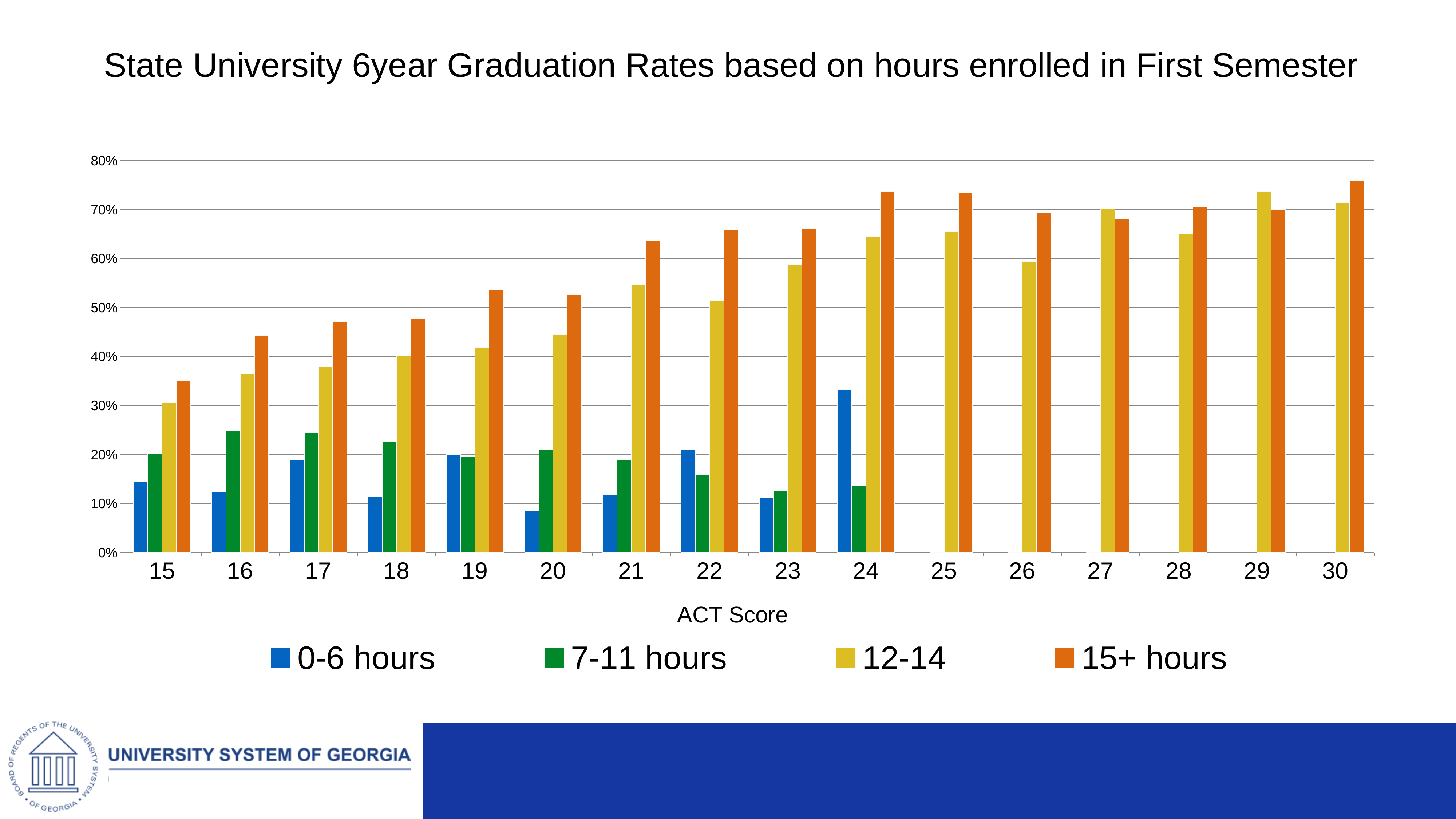
At ACT score 24, which is larger: 0-6 hours or 7-11 hours? 0-6 hours How many ACT score categories are shown on the x axis? 16 Is the value for 15+ hours at ACT score 30 greater or less than 70%? greater Do the 15+ hours values generally rise or fall as ACT score increases from 15 to 30? rise Is the value for 0-6 hours at ACT score 20 greater or less than 10%? less What kind of chart is shown on the slide? Bar chart Which series has the lowest bar at ACT score 18? 0-6 hours What is the title of the x axis? ACT Score Is the value for 12-14 at ACT score 21 greater or less than 50%? greater At which ACT score is the 15+ hours bar the highest? 30 How many series does the legend list? 4 At ACT score 29, which is larger: 12-14 or 15+ hours? 12-14